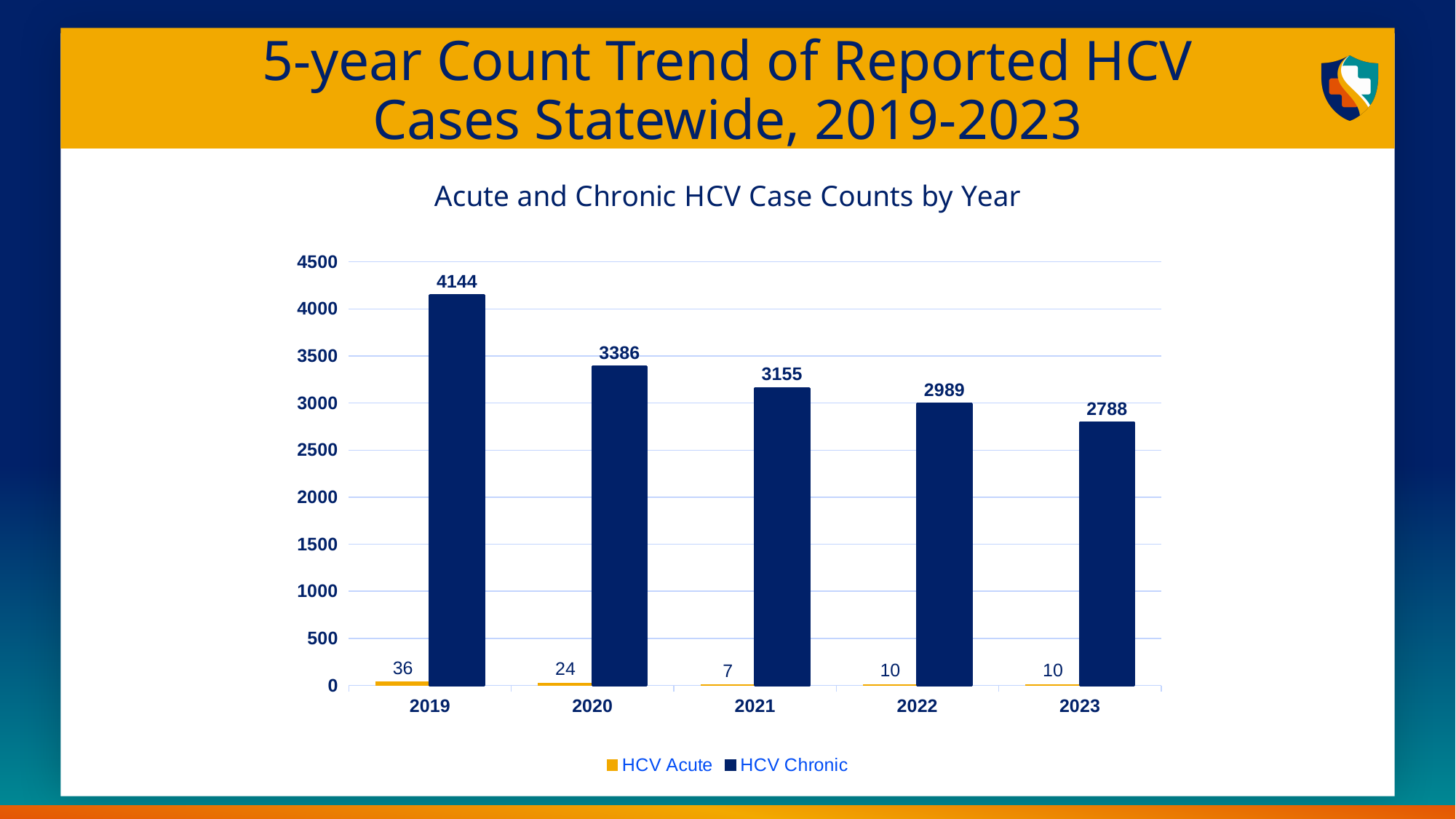
How many series does the legend list? 2 What kind of chart is shown? bar chart What is the difference between the HCV Chronic case counts for 2019 and 2023? 1356 How many years are shown on the x axis? 5 Which is larger, the HCV Acute count for 2019 or for 2020? 2019 What is the HCV Chronic case count for 2023? 2788 What is the HCV Chronic case count for 2019? 4144 Do the HCV Chronic case counts rise or fall from 2019 to 2023? fall Which year has the lowest HCV Acute case count? 2021 What is the HCV Acute case count for 2021? 7 Which year has the highest HCV Chronic case count? 2019 Is the HCV Chronic value for 2022 greater or less than 2500? greater